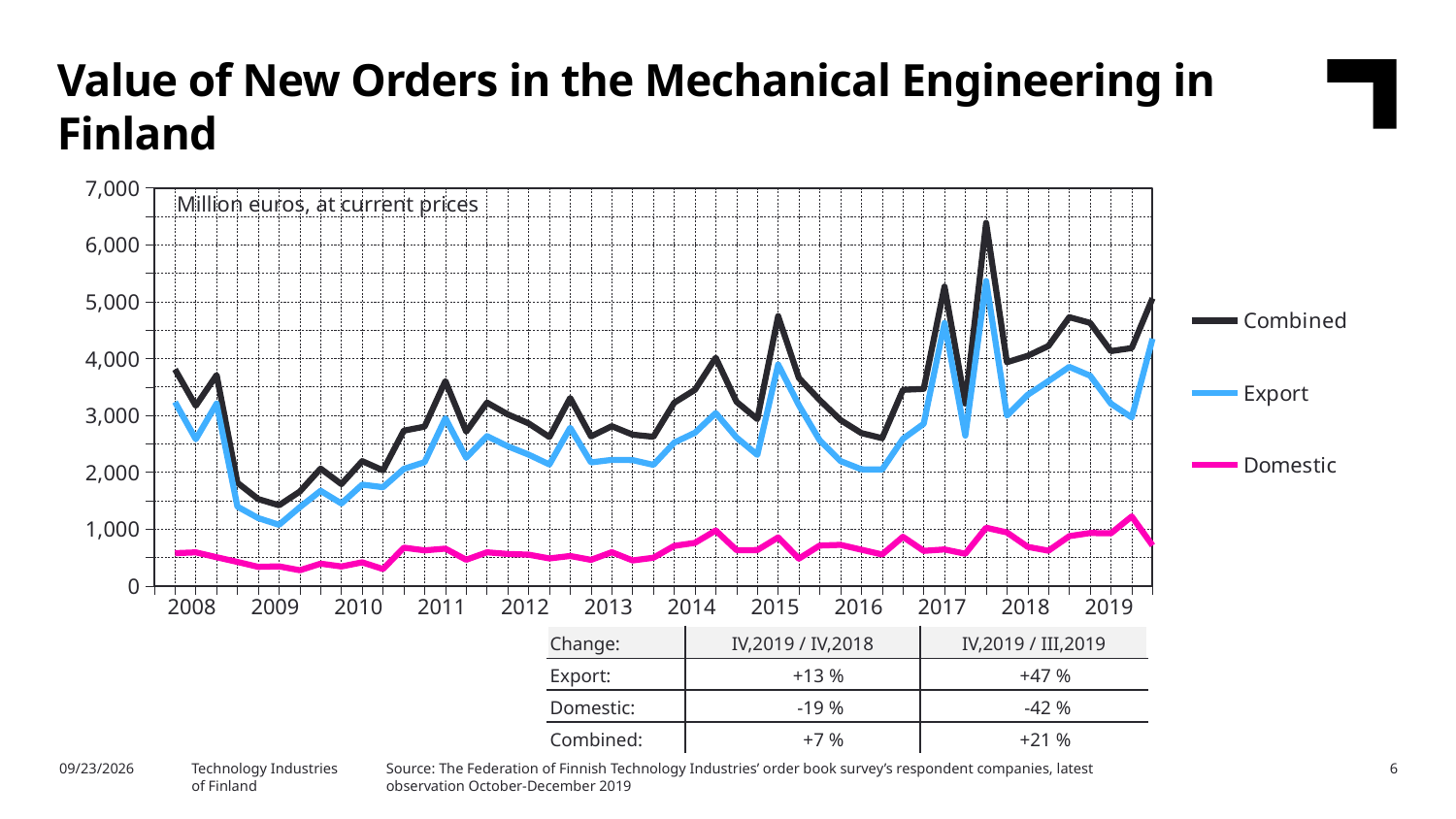
Is the peak value of the Combined series in 2017 greater or less than 6,000? greater Which series is larger in 2015, Export or Domestic? Export Is the lowest value of the Export series in 2009 greater or less than 2,000? less How many years are labelled on the x axis? 12 What are the three series named in the legend? Combined, Export, Domestic Which series has the lowest values throughout the chart? Domestic What unit note is printed inside the chart area? Million euros, at current prices Is the value for Domestic at the end of 2019 greater or less than 2,000? less What kind of chart is shown on the slide? Line chart Which series has the highest values throughout the chart? Combined How many series does the legend list? 3 Does the Combined series rise or fall from the start of 2008 to 2009? Fall